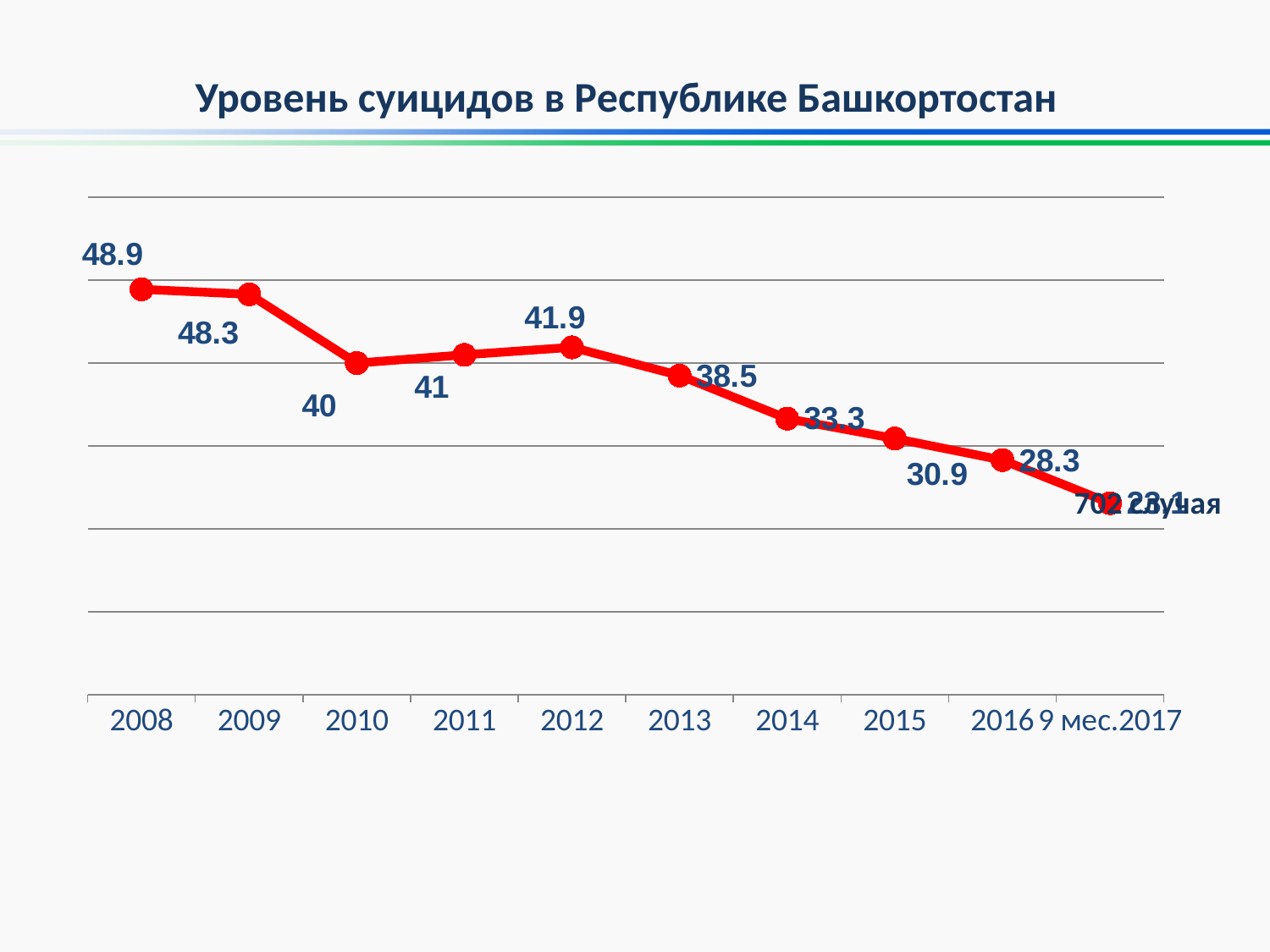
Which is larger, the value for 2011 or the value for 2012? 2012 What is the difference between the values for 2013 and 2014? 5.2 How many data points are plotted on the chart? 10 What is the value for 2010? 40 Which is larger, the value for 2009 or the value for 2010? 2009 Do the values generally rise or fall from 2008 to 2016? fall Which year has the highest value? 2008 What is the value for 2008? 48.9 What is the difference between the values for 2008 and 2016? 20.6 What is the value for 2015? 30.9 What is the value for 2012? 41.9 What kind of chart is shown on the slide? line chart